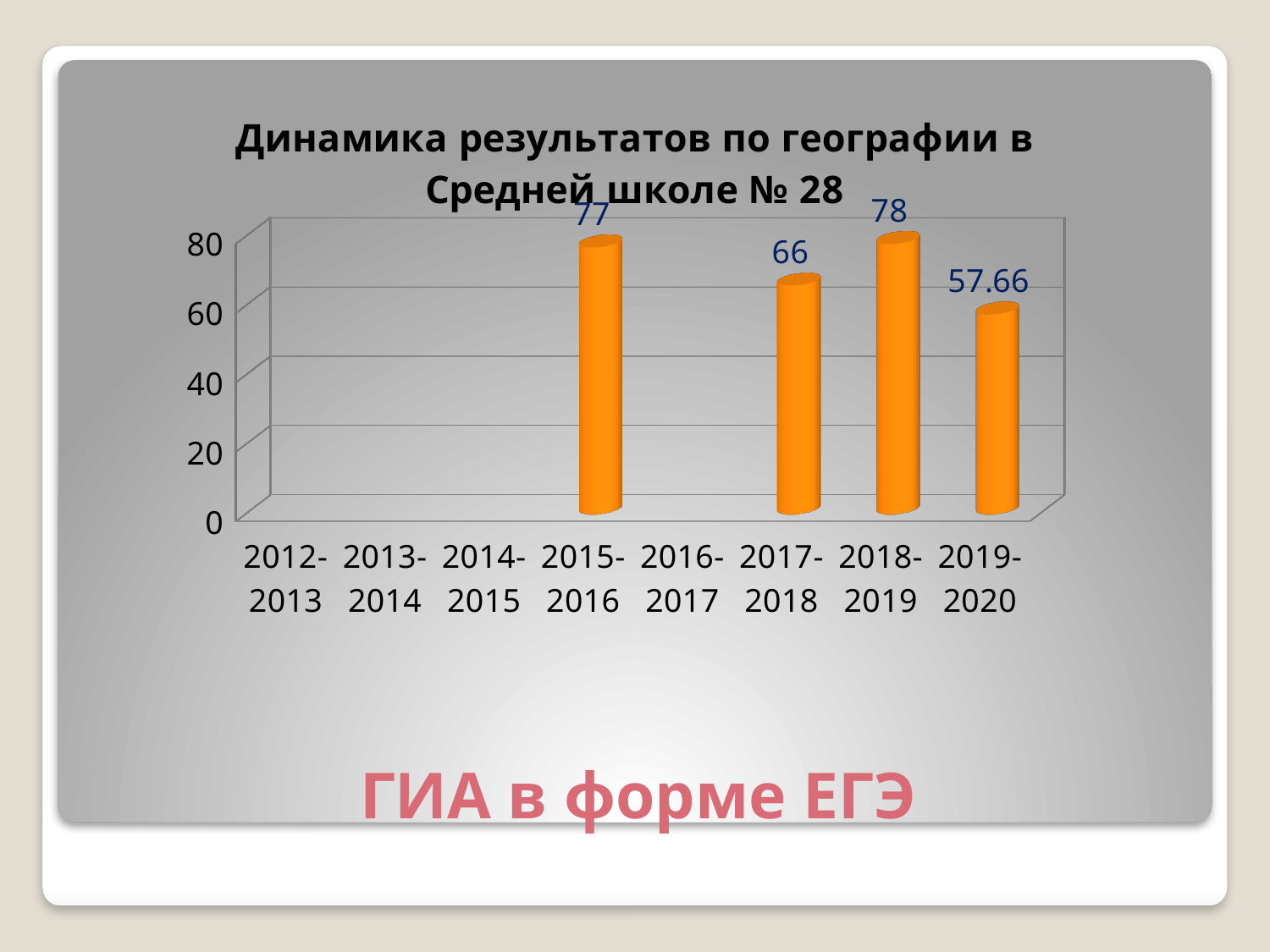
Among the years with a bar shown, which has the lowest value? 2019-2020 What is the difference between the values for 2018-2019 and 2015-2016? 1 What is the value for 2015-2016? 77 How many school-year categories are labelled on the x axis? 8 Which is larger, the value for 2017-2018 or the value for 2019-2020? 2017-2018 What is the title of the chart? Динамика результатов по географии в Средней школе № 28 What is the value for 2019-2020? 57.66 What is the value for 2017-2018? 66 What kind of chart is shown on the slide? bar chart Is the value for 2019-2020 greater or less than 60? less Which school year has the highest bar? 2018-2019 What is the difference between the values for 2015-2016 and 2017-2018? 11